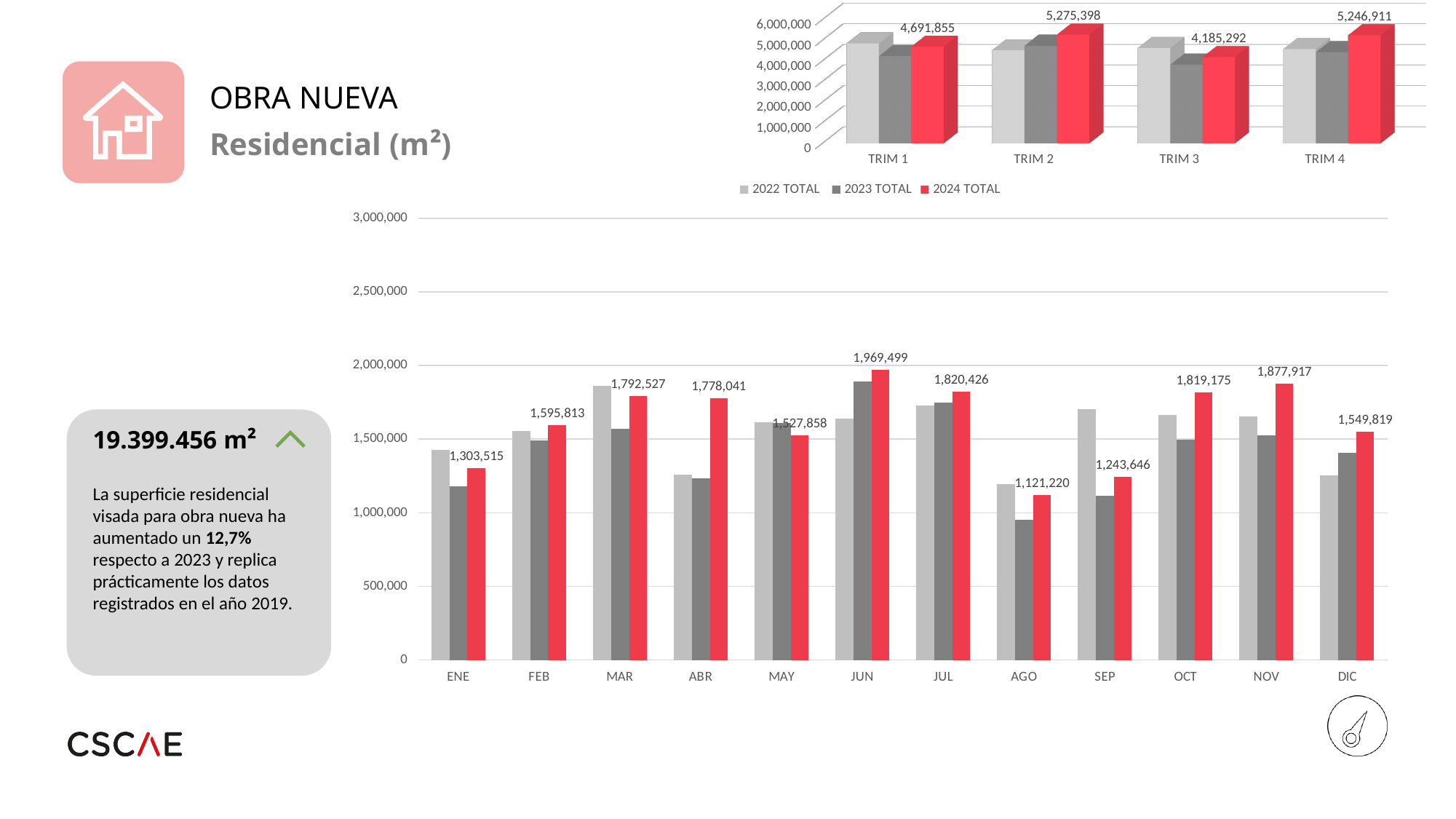
In the monthly chart at the bottom, how many months are shown on the x axis? 12 In the monthly chart at the bottom, which month has the lowest 2024 value? AGO In the monthly chart at the bottom, is the 2023 value for AGO greater or less than 1,000,000? less In the quarterly chart at the top right, what is the difference between the 2024 TOTAL values for TRIM 2 and TRIM 3? 1,090,106 In the quarterly chart at the top right, how many series does the legend list? 3 What kind of chart is the monthly chart at the bottom of the slide? Bar chart In the quarterly chart at the top right, is the 2022 TOTAL value for TRIM 1 greater or less than 4,000,000? greater In the monthly chart at the bottom, what is the 2024 value for JUN? 1,969,499 In the monthly chart at the bottom, which month has the highest 2024 value? JUN In the monthly chart at the bottom, what is the difference between the 2024 values for NOV and DIC? 328,098 In the quarterly chart at the top right, which quarter has the lowest 2024 TOTAL value? TRIM 3 In the quarterly chart at the top right, what is the 2024 TOTAL value for TRIM 2? 5,275,398